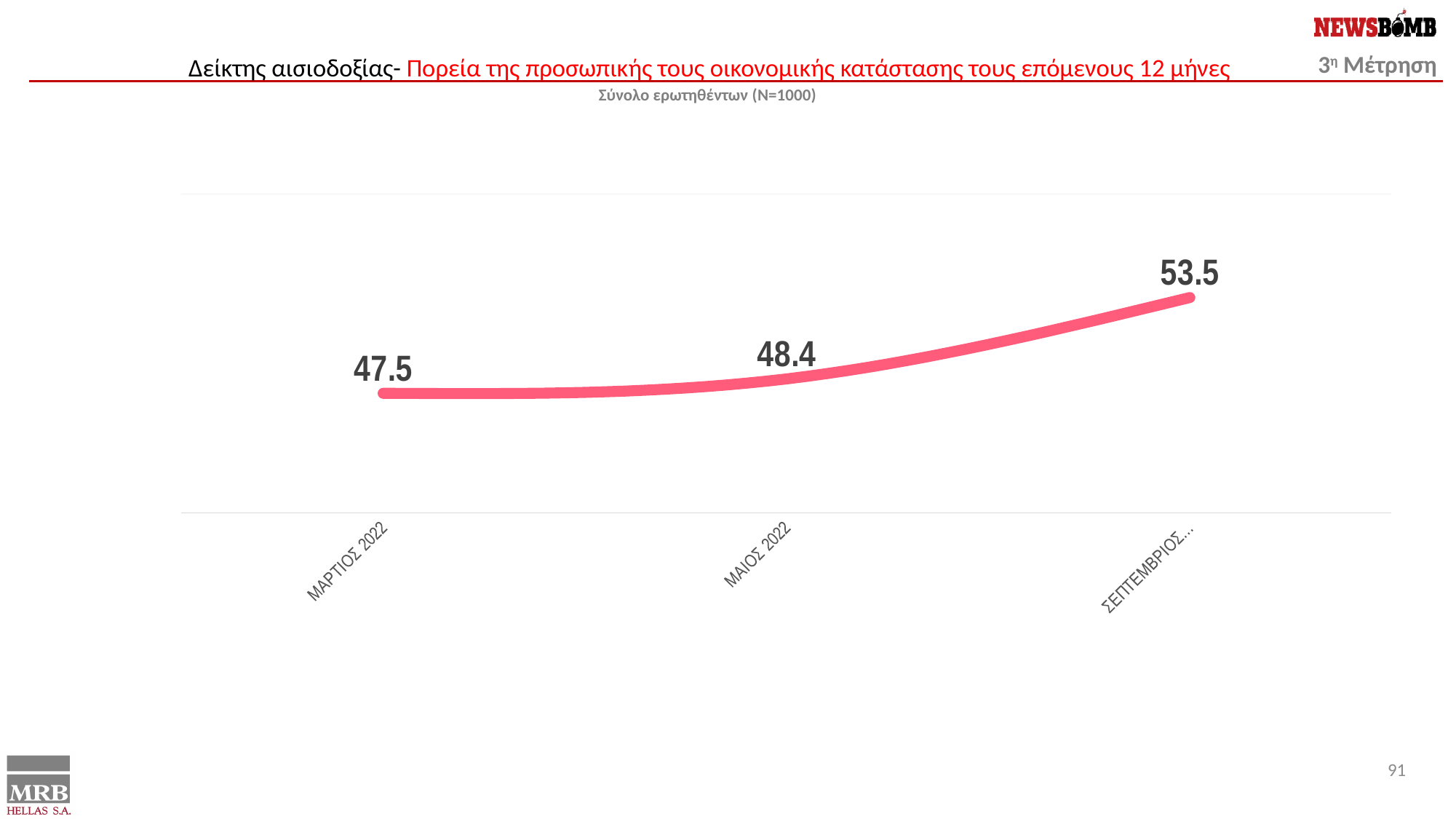
What is the value for ΜΑΡΤΙΟΣ 2022? 47.5 Which point on the chart has the lowest value? ΜΑΡΤΙΟΣ 2022 Which is larger, the value for ΜΑΙΟΣ 2022 or the value for ΣΕΠΤΕΜΒΡΙΟΣ? ΣΕΠΤΕΜΒΡΙΟΣ Do the values rise or fall from ΜΑΡΤΙΟΣ 2022 to ΣΕΠΤΕΜΒΡΙΟΣ? Rise How many data points are plotted on the chart? 3 What sample size is stated in the chart subtitle? N=1000 What is the difference between the ΣΕΠΤΕΜΒΡΙΟΣ value and the ΜΑΡΤΙΟΣ 2022 value? 6.0 Which point on the chart has the highest value? ΣΕΠΤΕΜΒΡΙΟΣ What is the difference between the ΜΑΙΟΣ 2022 value and the ΜΑΡΤΙΟΣ 2022 value? 0.9 What is the value for the ΣΕΠΤΕΜΒΡΙΟΣ point? 53.5 What kind of chart is shown on the slide? Line chart What is the value for ΜΑΙΟΣ 2022? 48.4